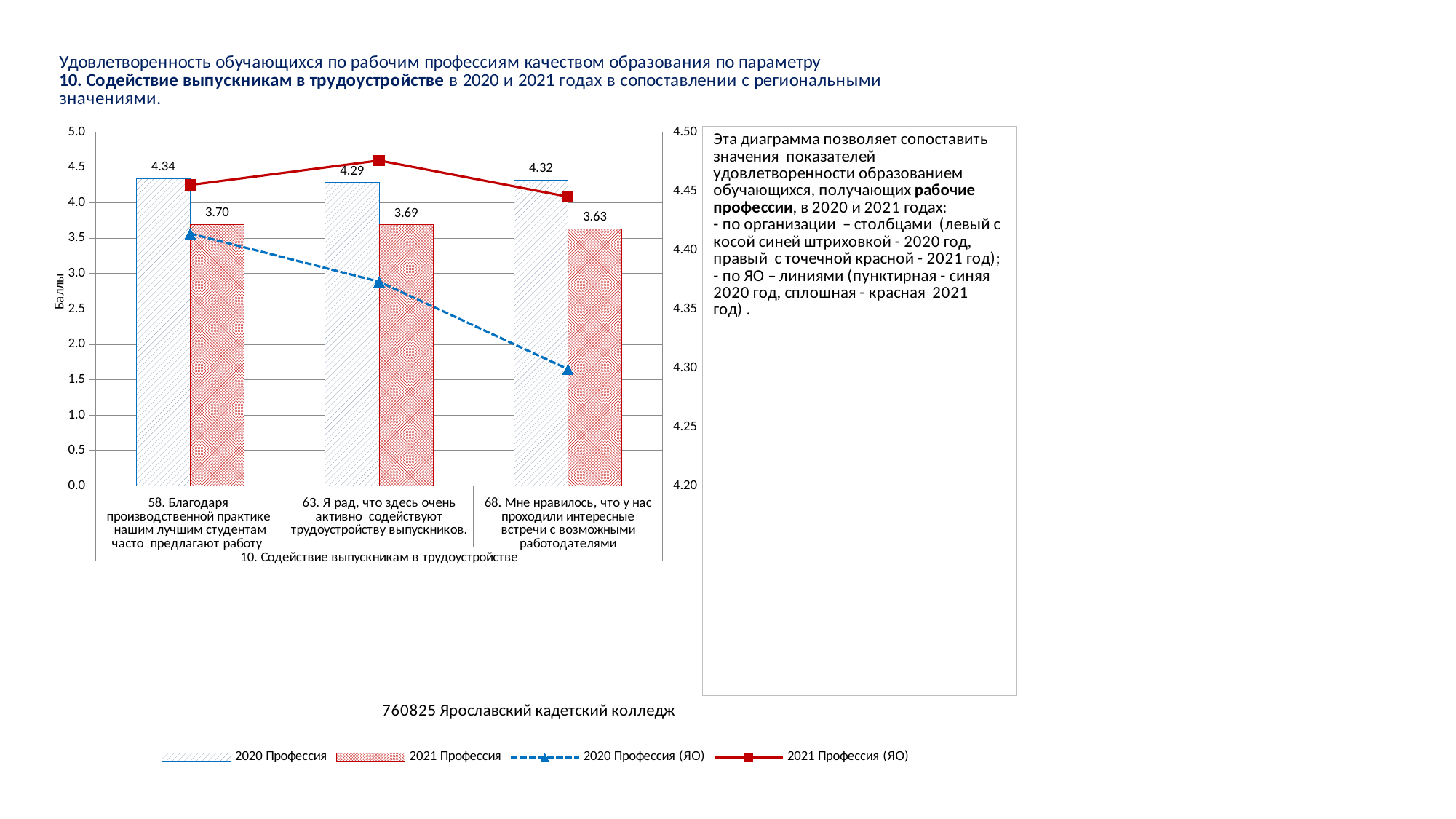
What is the value of the 2020 Профессия bar for item 58 (Благодаря производственной практике...)? 4.34 What is the value of the 2021 Профессия bar for item 68 (Мне нравилось, что у нас проходили интересные встречи...)? 3.63 For item 68, which is larger: the 2020 Профессия bar or the 2021 Профессия bar? 2020 Профессия Which item has the lowest 2021 Профессия bar? 68. Мне нравилось, что у нас проходили интересные встречи с возможными работодателями What is the difference between the 2020 Профессия and 2021 Профессия bars for item 58? 0.64 Do the 2020 Профессия (ЯО) line values rise or fall from item 58 to item 68? fall How many series does the chart legend list? 4 What is the value of the 2021 Профессия bar for item 63 (Я рад, что здесь очень активно содействуют трудоустройству выпускников)? 3.69 How many items (categories) are shown on the x axis of the chart? 3 Is the 2021 Профессия (ЯО) value for item 63 greater or less than 4.45 on the right axis? greater Is the 2020 Профессия (ЯО) value for item 68 greater or less than 4.35 on the right axis? less Which item has the highest 2020 Профессия bar? 58. Благодаря производственной практике нашим лучшим студентам часто предлагают работу